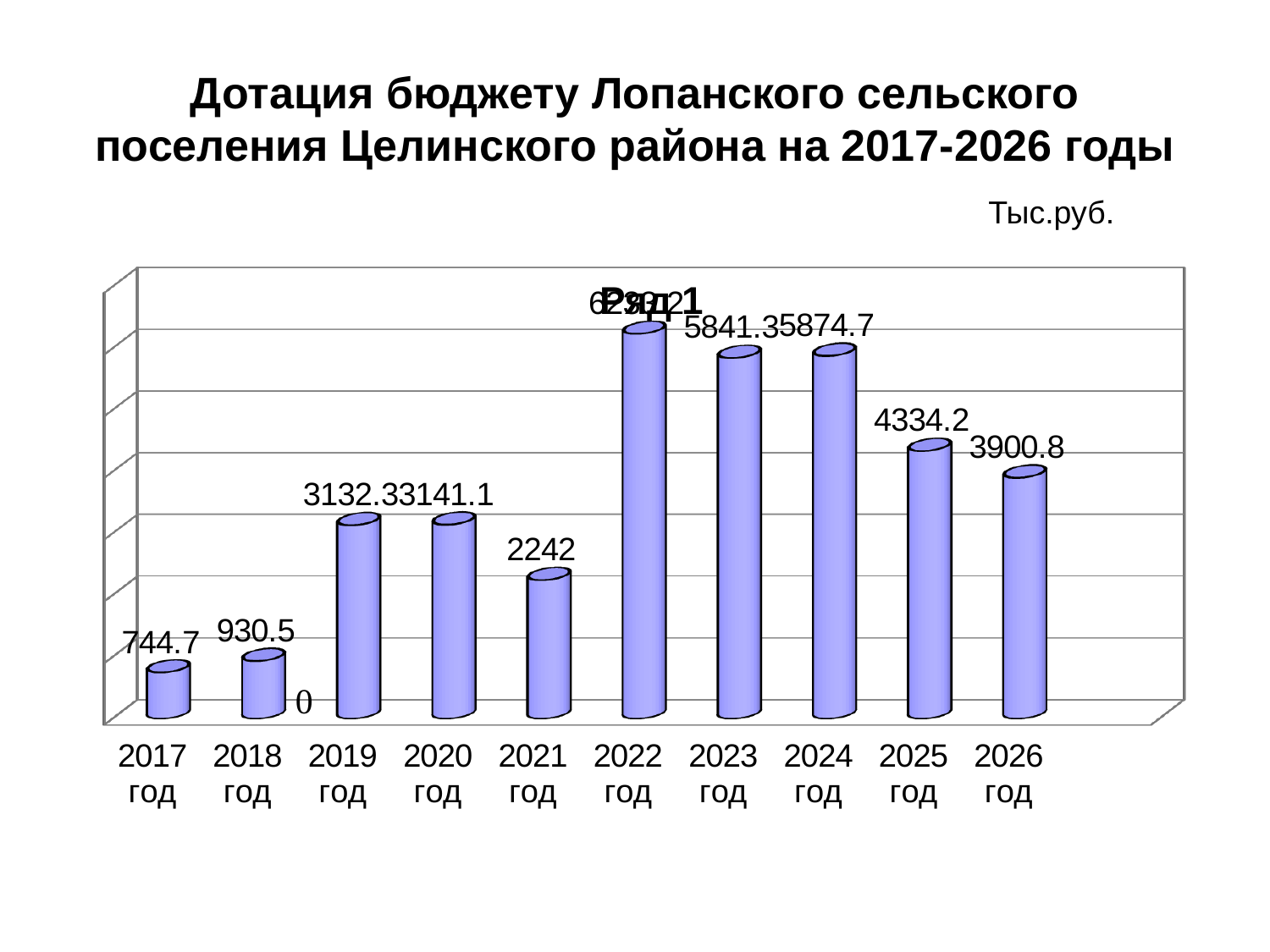
Which year has the lowest value? 2017 год What kind of chart is this? bar chart What is the difference between the values for 2024 год and 2023 год? 33.4 What is the value for 2025 год? 4334.2 Which is larger, the value for 2025 год or 2026 год? 2025 год How many years are shown on the x axis? 10 What is the difference between the values for 2025 год and 2026 год? 433.4 What is the value for 2021 год? 2242 What unit is stated above the chart? Тыс.руб. What is the value for 2019 год? 3132.3 Which year has the highest value? 2022 год Do the values rise or fall from 2022 год to 2026 год? fall